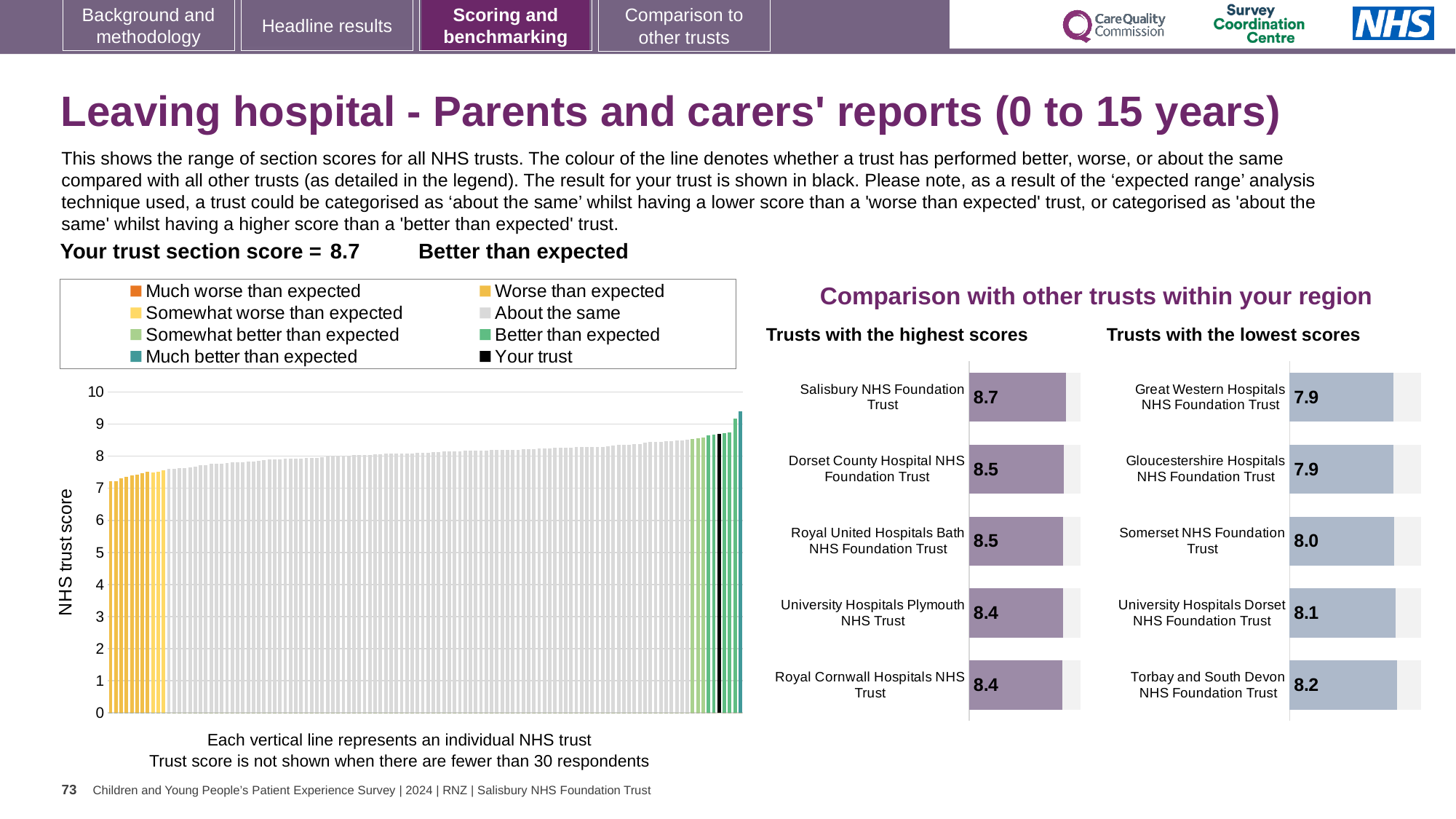
How many entries does the legend of the NHS trust score chart list? 8 In the 'Trusts with the lowest scores' chart, which trust has the highest score? Torbay and South Devon NHS Foundation Trust In the NHS trust score chart, are the yellow 'Worse than expected' bars greater or less than 8? less In the 'Trusts with the highest scores' chart, what is the score for Salisbury NHS Foundation Trust? 8.7 In the 'Trusts with the highest scores' chart, which trust has the highest score? Salisbury NHS Foundation Trust In the 'Trusts with the highest scores' chart, what is the difference between the scores of Salisbury NHS Foundation Trust and Royal Cornwall Hospitals NHS Trust? 0.3 In the 'Trusts with the lowest scores' chart, what is the difference between the scores of Torbay and South Devon NHS Foundation Trust and Great Western Hospitals NHS Foundation Trust? 0.3 In the 'Trusts with the highest scores' chart, what is the score for University Hospitals Plymouth NHS Trust? 8.4 In the 'Trusts with the lowest scores' chart, what is the score for Somerset NHS Foundation Trust? 8.0 In the 'Trusts with the lowest scores' chart, which has the larger score: University Hospitals Dorset NHS Foundation Trust or Gloucestershire Hospitals NHS Foundation Trust? University Hospitals Dorset NHS Foundation Trust In the NHS trust score chart, do the trust scores rise or fall from left to right? rise How many trusts are shown in the 'Trusts with the highest scores' chart? 5